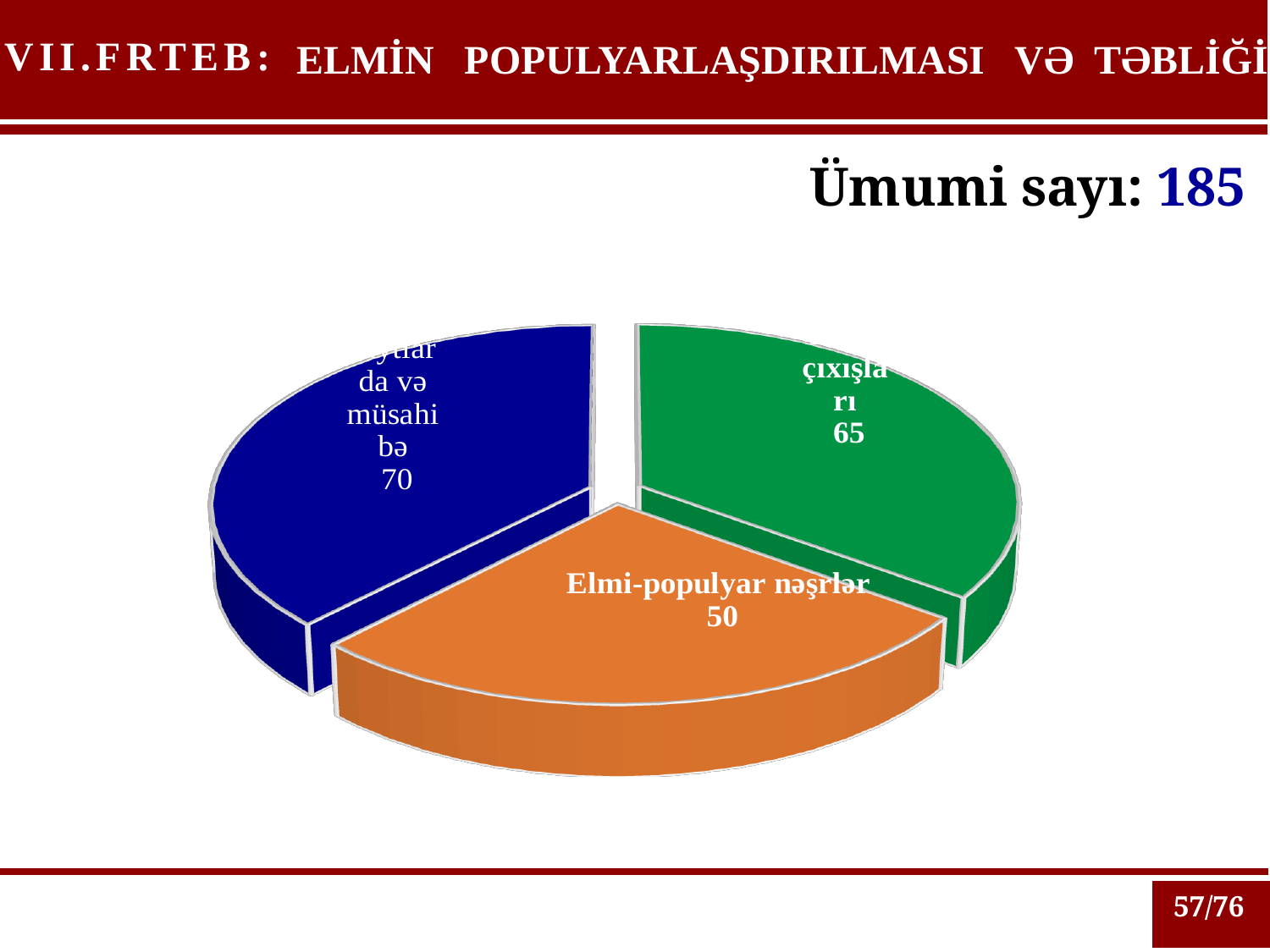
Which is larger, the value for çıxışları or the value for Elmi-populyar nəşrlər? çıxışları What is the value shown for çıxışları (the green slice)? 65 What is the difference between the values for çıxışları and Elmi-populyar nəşrlər? 15 What colour is the Elmi-populyar nəşrlər slice? orange What is the value shown for Elmi-populyar nəşrlər? 50 What kind of chart is shown on the slide? pie chart What total number (Ümumi sayı) is stated on the slide? 185 Which slice of the pie chart has the smallest value? Elmi-populyar nəşrlər What is the difference between the blue slice's value and the value for Elmi-populyar nəşrlər? 20 How many slices does the pie chart have? 3 What is the value shown on the blue slice of the pie chart? 70 Which slice of the pie chart has the largest value? the blue slice (70)